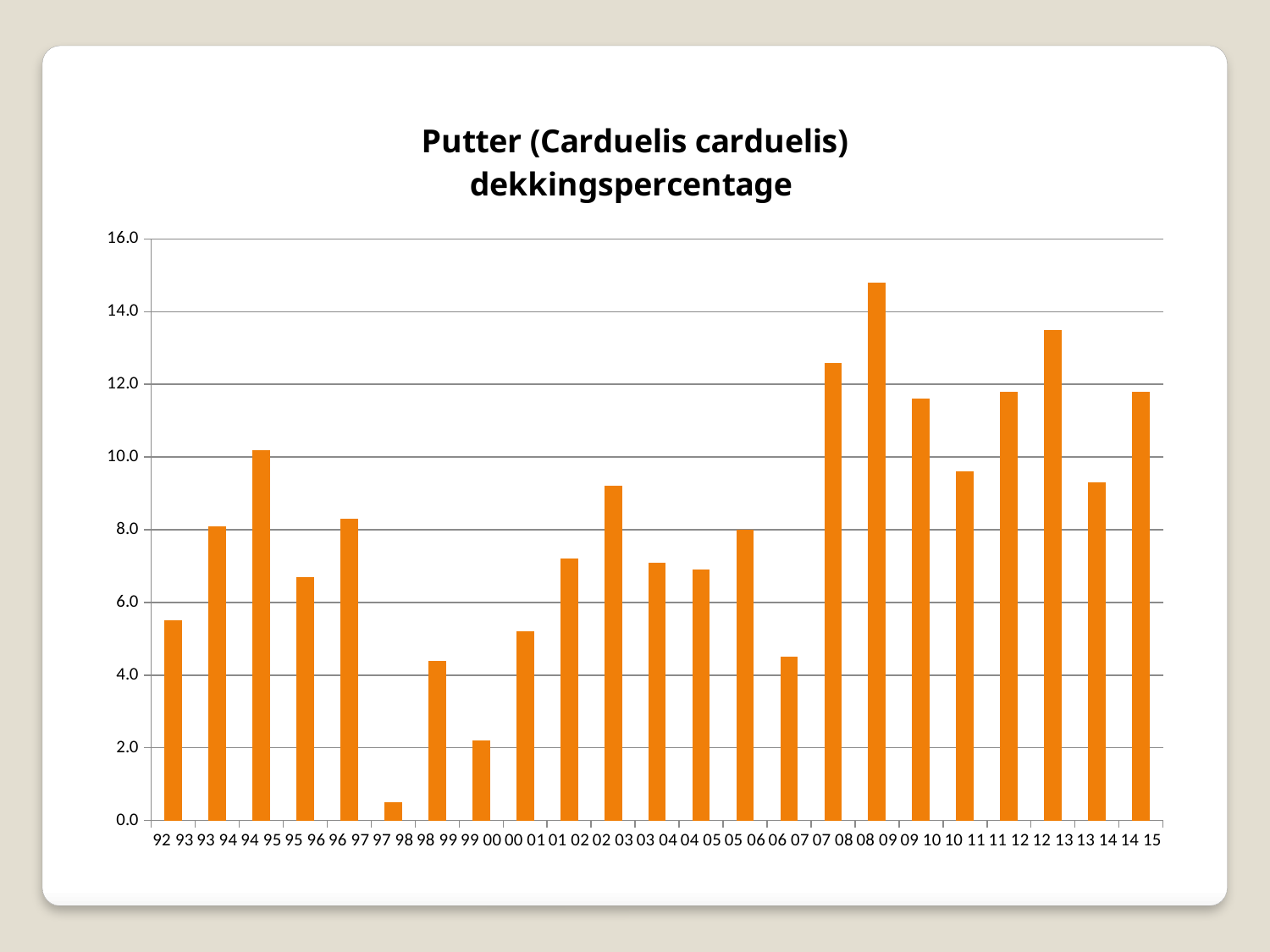
Is the value for 99 00 greater or less than 4.0? less Which is larger, the value for 08 09 or the value for 12 13? 08 09 Is the value for 07 08 greater or less than 12.0? greater Which season has the lowest bar? 97 98 What kind of chart is shown on the slide? bar chart Which season has the highest bar? 08 09 What is the title of the chart? Putter (Carduelis carduelis) dekkingspercentage What is the highest value shown on the vertical axis? 16.0 Is the value for 02 03 greater or less than 8.0? greater How many bars (seasons) are plotted in the chart? 23